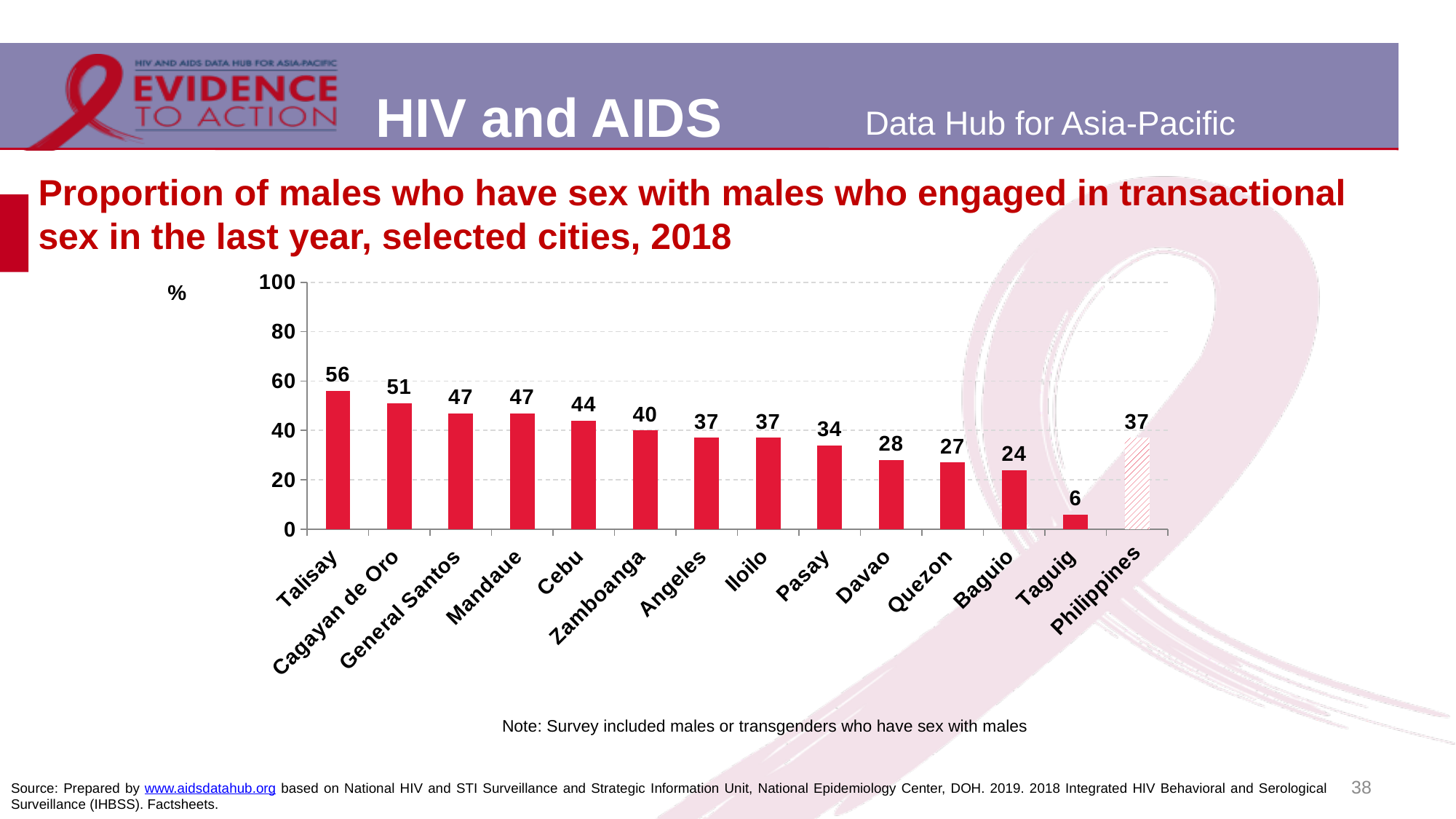
What kind of chart is shown on the slide? bar chart What is the difference between the values for Talisay and Cagayan de Oro? 5 Which category has the lowest value? Taguig Is the value for Baguio greater or less than 40? less Which city has the highest value? Talisay What is the value for Philippines? 37 What is the value for Zamboanga? 40 Which is larger, the value for Cebu or the value for Davao? Cebu What is the unit shown on the y axis label? % How many categories are shown on the x axis? 14 What is the value for Taguig? 6 What is the value for Talisay? 56